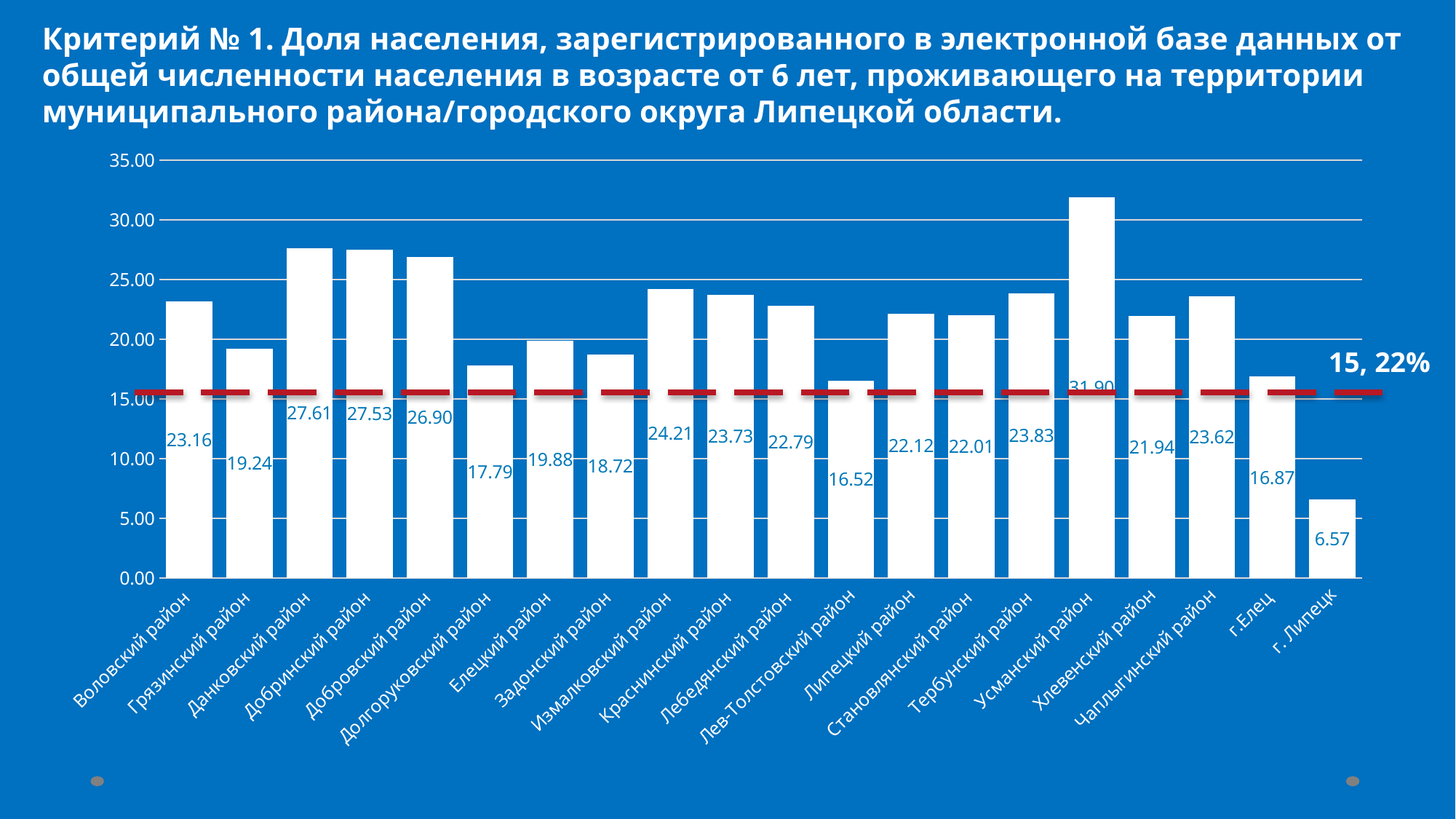
What is the difference between the values for Воловский район and Грязинский район? 3.92 Which is larger, the value for Измалковский район or the value for Краснинский район? Измалковский район Which category has the highest value? Усманский район Is the value for Добровский район greater or less than 25.00? greater What value is shown for Данковский район? 27.61 What value is shown for Лев-Толстовский район? 16.52 Which category has the lowest value? г. Липецк What value is shown for г.Елец? 16.87 What kind of chart is shown on the slide? bar chart What value is labelled next to the red dashed horizontal line? 15, 22% How many categories are shown on the x axis? 20 What is the difference between the values for Усманский район and г. Липецк? 25.33